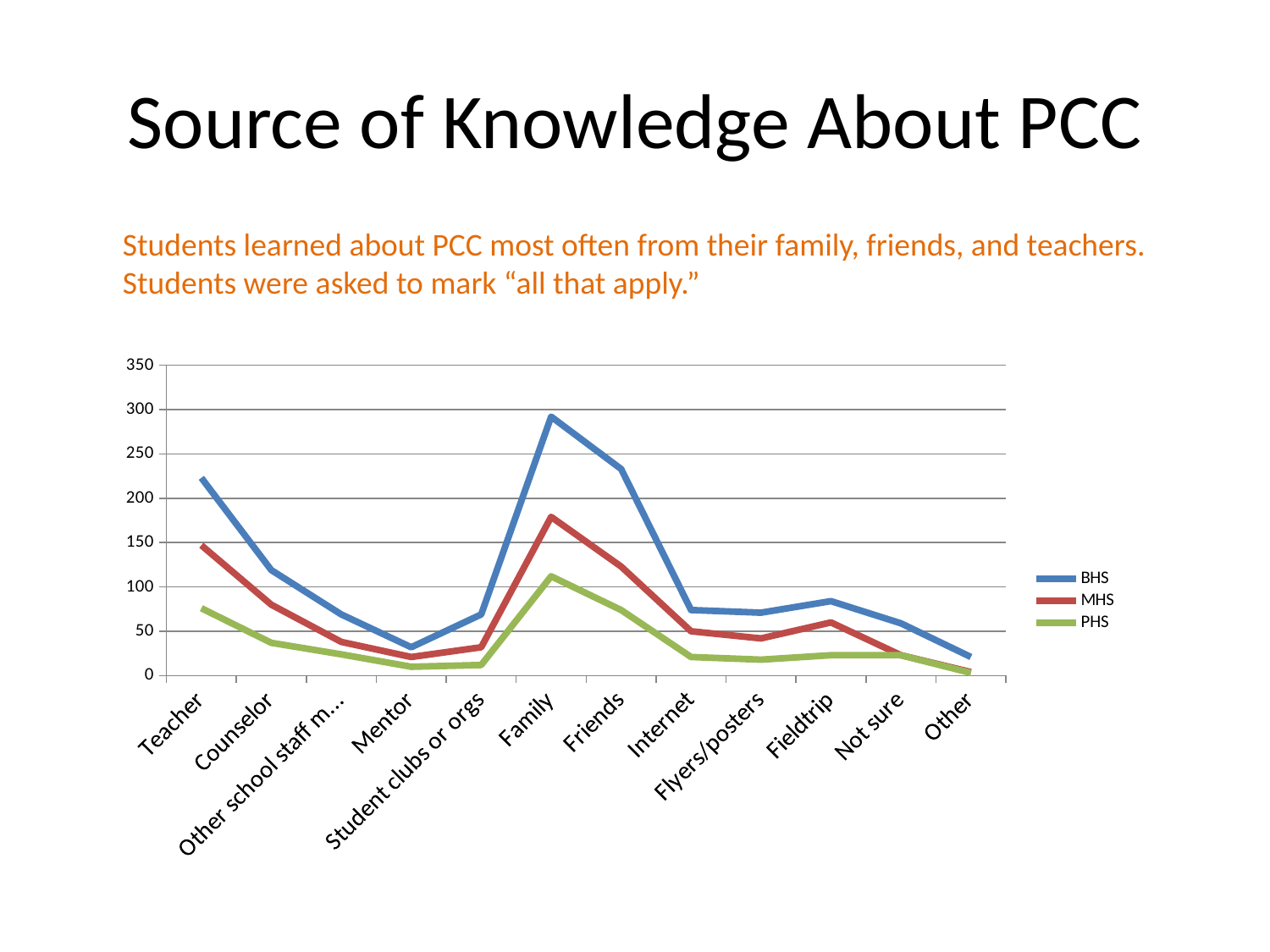
Which colour is used for the PHS line? green For which category is the MHS line highest? Family Is the BHS value for Family greater or less than 250? greater For which category is the BHS line lowest? Other For which category is the BHS line highest? Family How many categories are shown along the x axis? 12 Is the MHS value for Teacher greater or less than 100? greater Which series has the larger value for Family, BHS or PHS? BHS Is the BHS value for Mentor greater or less than 50? less How many series does the legend list? 3 What kind of chart is shown on the slide? line chart